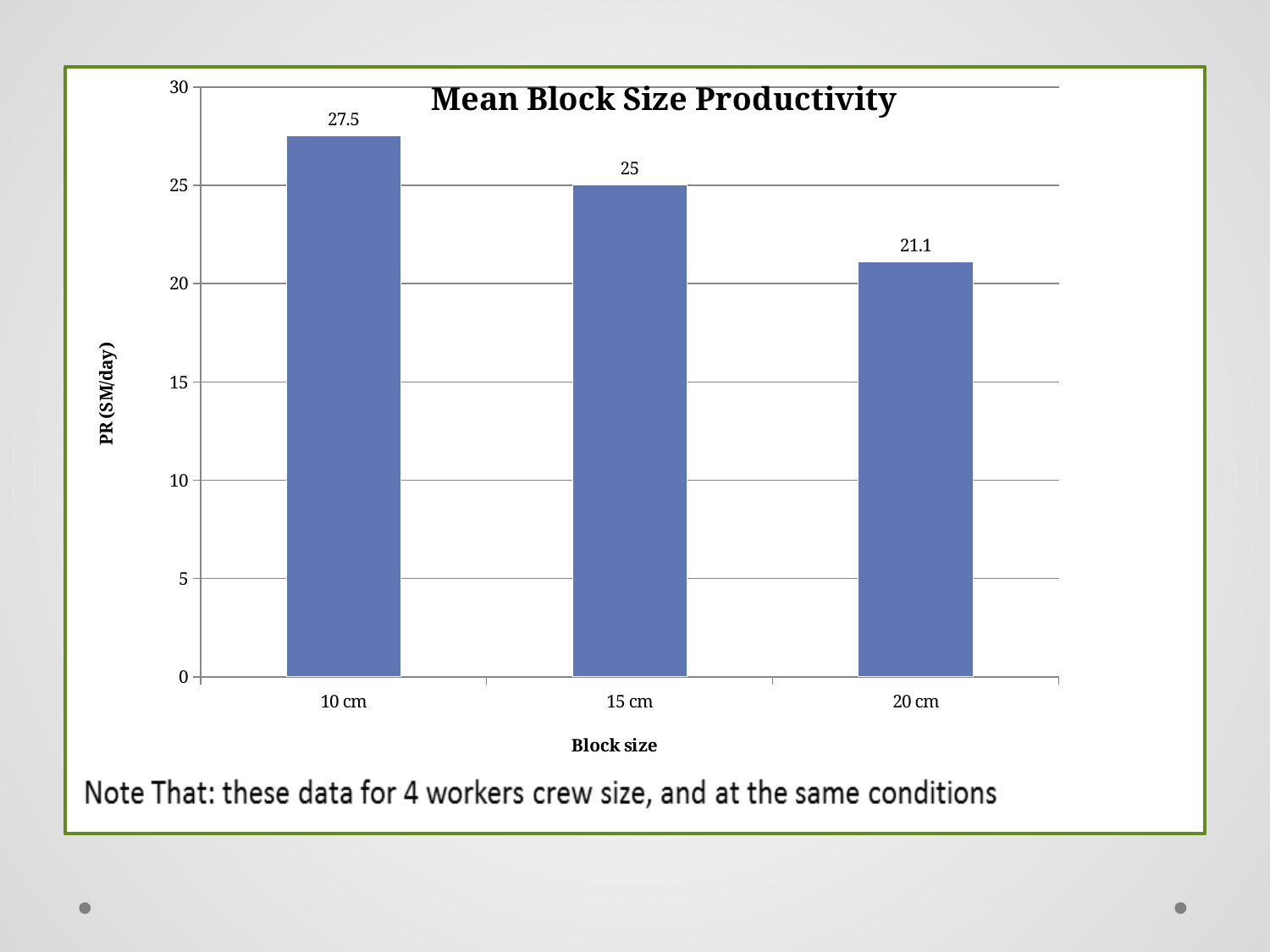
What is the difference in mean productivity between the 10 cm and 20 cm block sizes? 6.4 What is the mean productivity (PR) for the 10 cm block size? 27.5 What is the mean productivity (PR) for the 20 cm block size? 21.1 What kind of chart is shown on the slide? Bar chart Which block size has the highest mean productivity? 10 cm Which has a higher mean productivity, the 15 cm or the 20 cm block size? 15 cm What is the mean productivity (PR) for the 15 cm block size? 25 What is the difference in mean productivity between the 15 cm and 20 cm block sizes? 3.9 Do the productivity values rise or fall as block size increases along the x axis? Fall Which block size has the lowest mean productivity? 20 cm Is the value for the 20 cm block size greater or less than 25? less How many block sizes are shown on the chart? 3